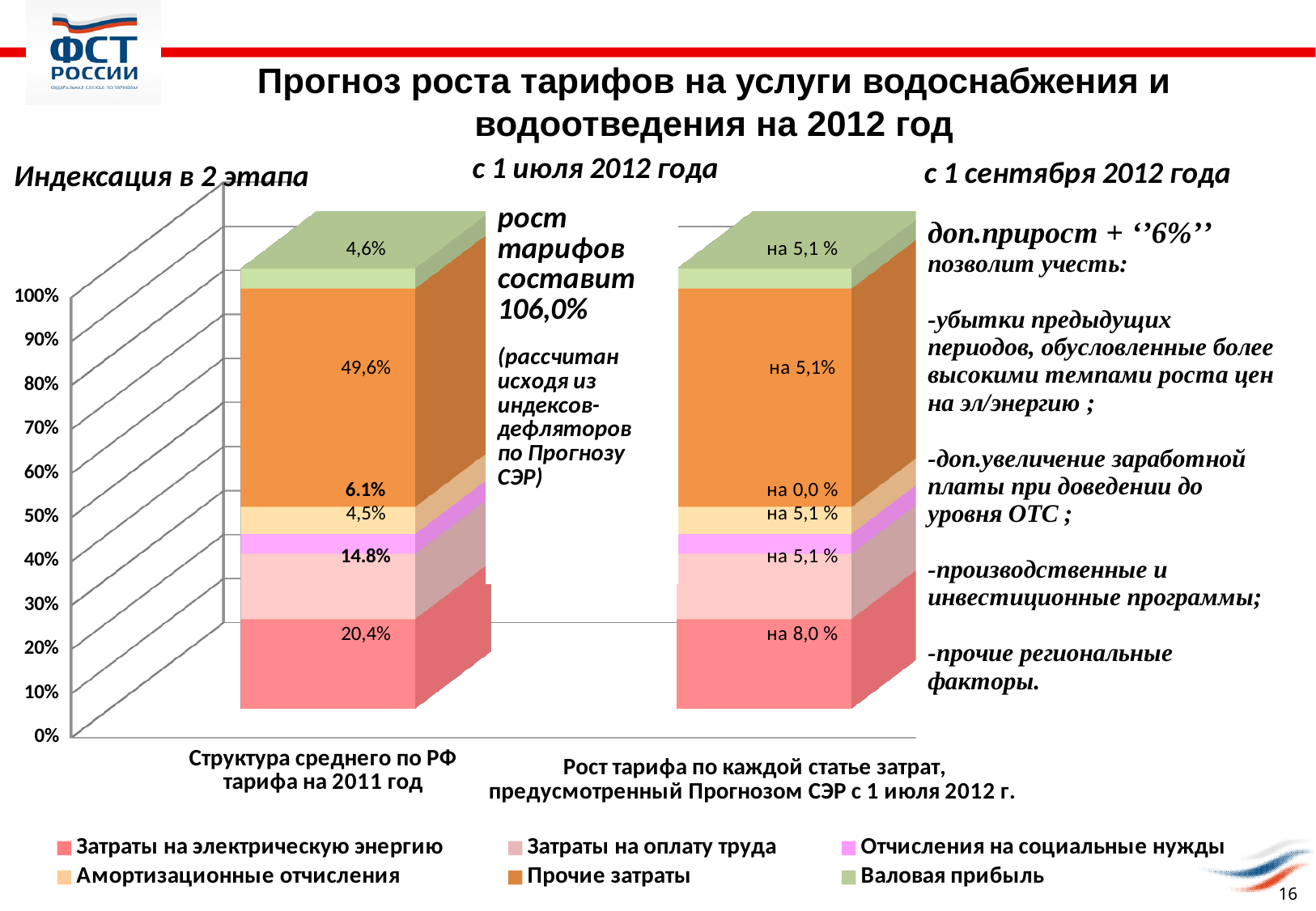
In the bar 'Структура среднего по РФ тарифа на 2011 год', which is larger: the share of 'Затраты на электрическую энергию' or 'Затраты на оплату труда'? Затраты на электрическую энергию Which cost item has the largest share in the bar 'Структура среднего по РФ тарифа на 2011 год'? Прочие затраты In the bar 'Структура среднего по РФ тарифа на 2011 год', what is the difference between the shares of 'Прочие затраты' and 'Затраты на электрическую энергию'? 29,2 percentage points How many bars are plotted in the chart? 2 How many series does the chart legend list? 6 In the bar 'Структура среднего по РФ тарифа на 2011 год', what share is labelled for 'Затраты на электрическую энергию'? 20,4% In the bar 'Структура среднего по РФ тарифа на 2011 год', what share is labelled for 'Прочие затраты'? 49,6% In the bar 'Рост тарифа по каждой статье затрат', what growth is labelled for 'Затраты на электрическую энергию'? на 8,0 % In the bar 'Структура среднего по РФ тарифа на 2011 год', what share is labelled for 'Затраты на оплату труда'? 14.8% In the bar 'Структура среднего по РФ тарифа на 2011 год', what share is labelled for 'Валовая прибыль'? 4,6% What colour represents 'Валовая прибыль' in the legend? Green What kind of chart is shown on the slide? Stacked bar chart